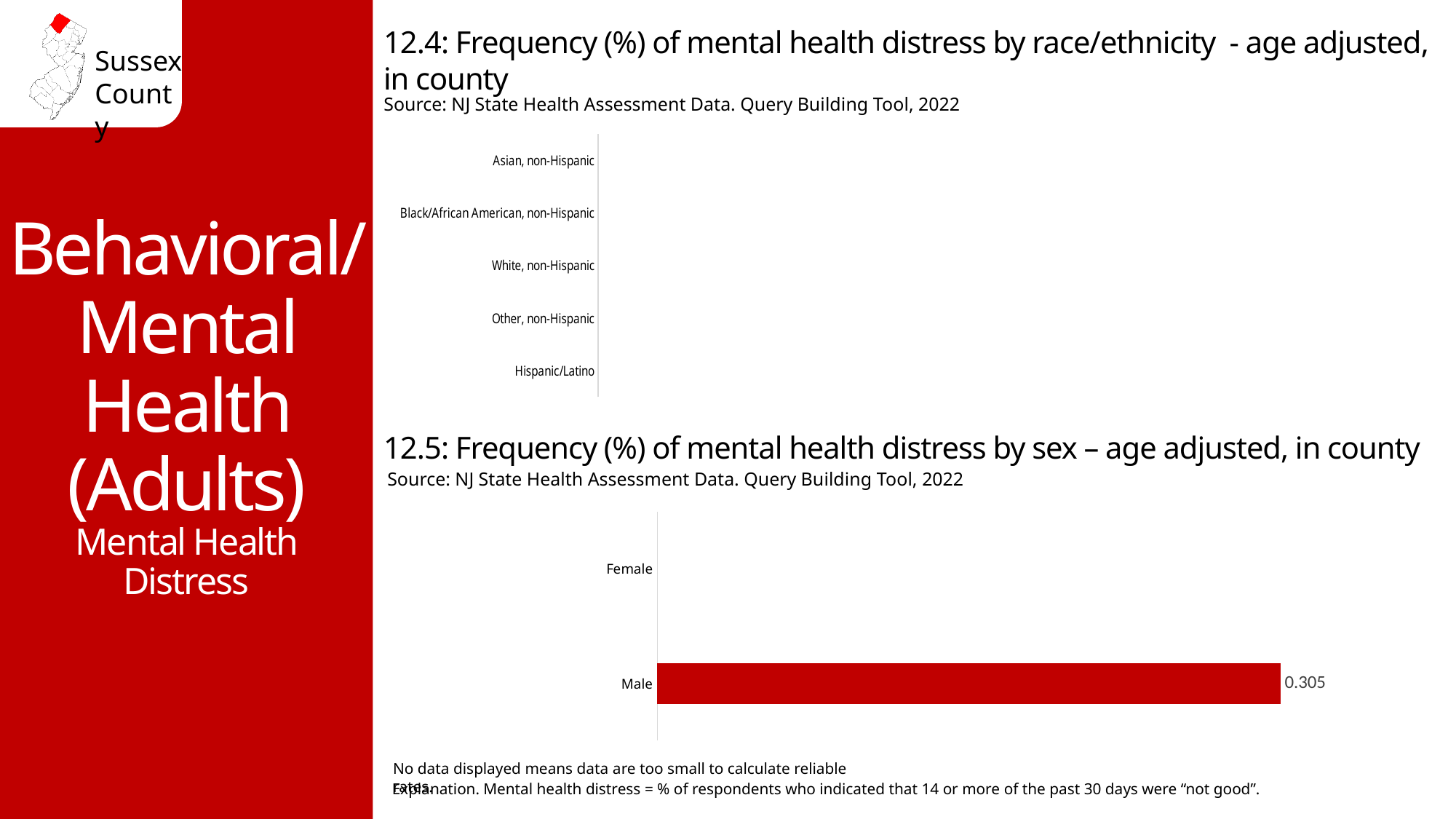
In the chart titled '12.5: Frequency (%) of mental health distress by sex – age adjusted, in county', how many categories are listed on the axis? 2 In the chart titled '12.5: Frequency (%) of mental health distress by sex – age adjusted, in county', which category has a bar displayed? Male In the chart titled '12.5: Frequency (%) of mental health distress by sex – age adjusted, in county', what is the value shown for Male? 0.305 In the chart titled '12.4: Frequency (%) of mental health distress by race/ethnicity - age adjusted, in county', how many race/ethnicity categories are listed on the axis? 5 In the chart titled '12.5: Frequency (%) of mental health distress by sex – age adjusted, in county', which category has no data displayed? Female What kind of chart is the chart titled '12.5: Frequency (%) of mental health distress by sex – age adjusted, in county'? Bar chart In the chart titled '12.4: Frequency (%) of mental health distress by race/ethnicity - age adjusted, in county', which category is listed at the top of the axis? Asian, non-Hispanic In the chart titled '12.5: Frequency (%) of mental health distress by sex – age adjusted, in county', what colour is the bar for Male? Red